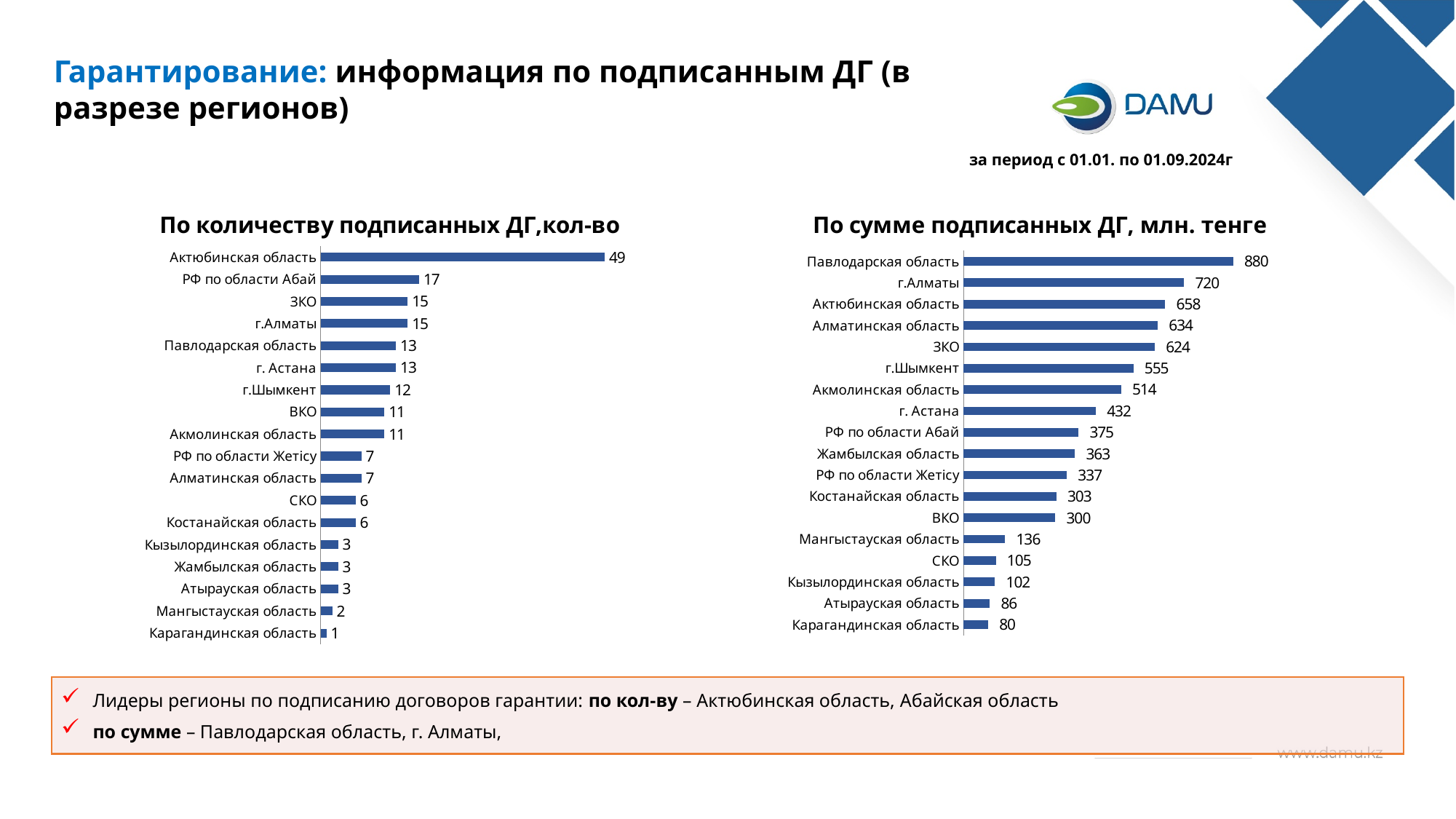
In the chart 'По количеству подписанных ДГ,кол-во', what is the value for Актюбинская область? 49 In the chart 'По сумме подписанных ДГ, млн. тенге', what is the value for ВКО? 300 What type of chart is 'По количеству подписанных ДГ,кол-во'? Bar chart In the chart 'По сумме подписанных ДГ, млн. тенге', which region has the highest value? Павлодарская область What period do the charts on the slide cover? с 01.01. по 01.09.2024г In the chart 'По сумме подписанных ДГ, млн. тенге', what is the difference between Павлодарская область and Карагандинская область? 800 In the chart 'По сумме подписанных ДГ, млн. тенге', what is the value for г.Алматы? 720 How many regions are shown in the chart 'По сумме подписанных ДГ, млн. тенге'? 18 In the chart 'По сумме подписанных ДГ, млн. тенге', which is larger: г.Шымкент or г. Астана? г.Шымкент In the chart 'По количеству подписанных ДГ,кол-во', what is the difference between Актюбинская область and РФ по области Абай? 32 In the chart 'По количеству подписанных ДГ,кол-во', which is larger: Павлодарская область or Мангыстауская область? Павлодарская область In the chart 'По количеству подписанных ДГ,кол-во', which region has the lowest value? Карагандинская область